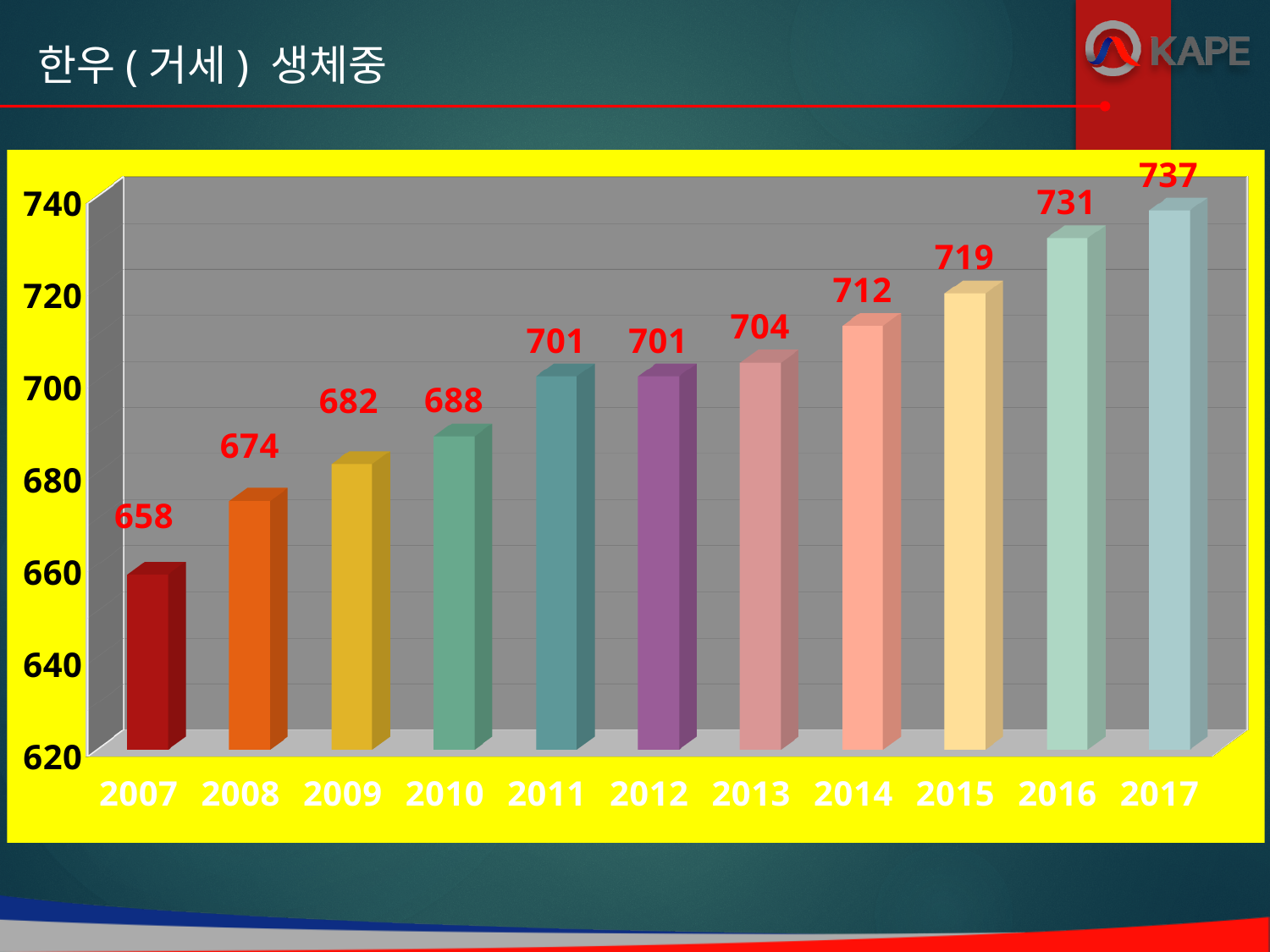
What is the difference between the values for 2017 and 2007? 79 What kind of chart is shown on the slide? bar chart Do the values rise or fall from 2007 to 2017? rise What is the value for 2012? 701 What is the value for 2015? 719 What is the difference between the values for 2010 and 2009? 6 How many years are shown on the x axis? 11 What is the value for 2007? 658 Is the value for 2016 greater or less than 720? greater Which is larger, the value for 2014 or the value for 2013? 2014 Which year has the lowest value? 2007 Which year has the highest value? 2017